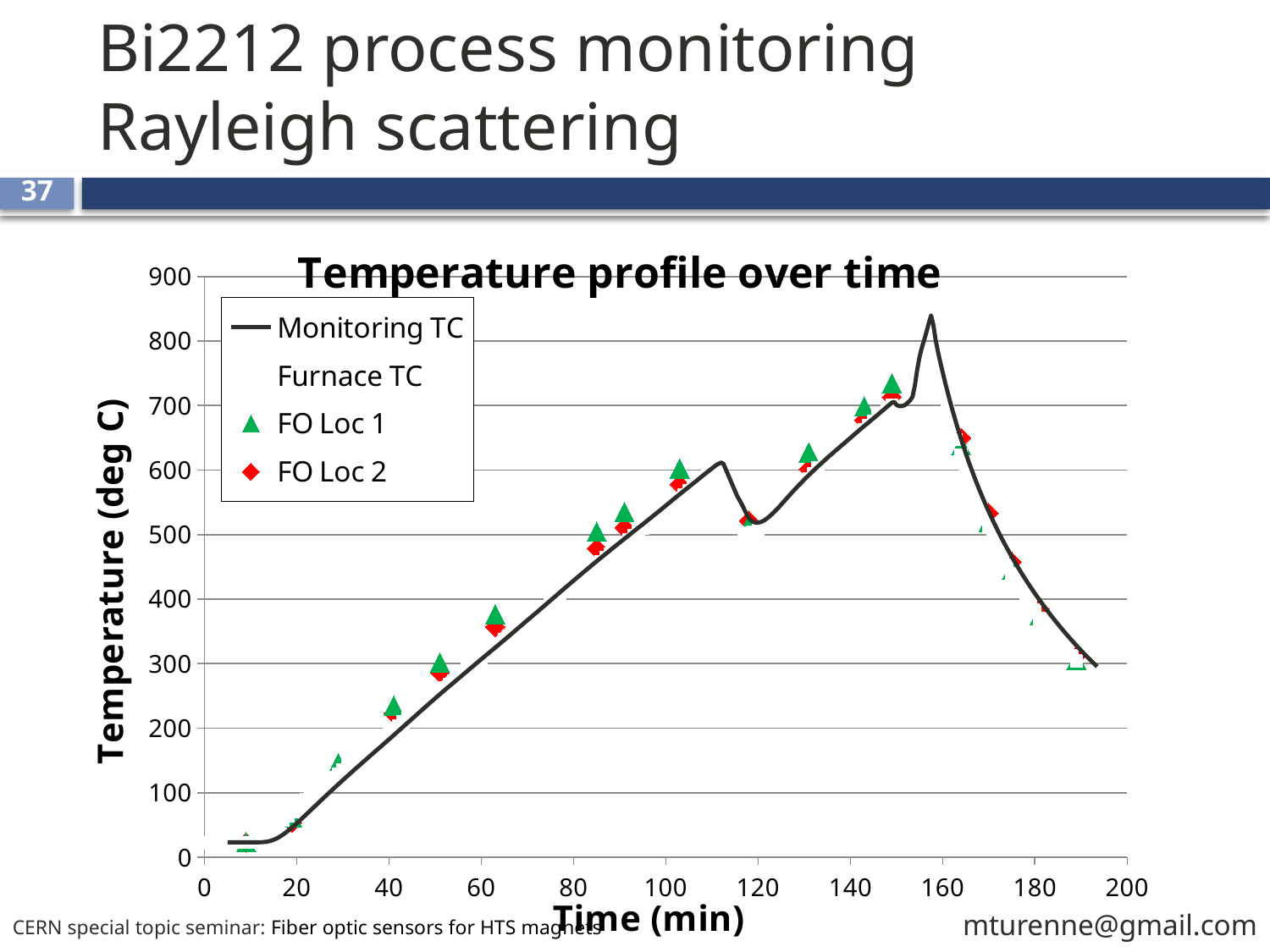
What is the title of the chart? Temperature profile over time Does the Monitoring TC temperature rise or fall between 0 and 100 min? rise What is the label of the y axis? Temperature (deg C) How many series does the chart legend list? 4 What kind of chart is shown on the slide? Line chart Is the Monitoring TC value at 40 min greater or less than 200? less Is the Monitoring TC value at 120 min greater or less than 500? greater Is the Monitoring TC value at 20 min greater or less than 100? less Which is larger, the Monitoring TC value at 150 min or at 190 min? 150 min Does the Monitoring TC temperature rise or fall between 160 and 190 min? fall